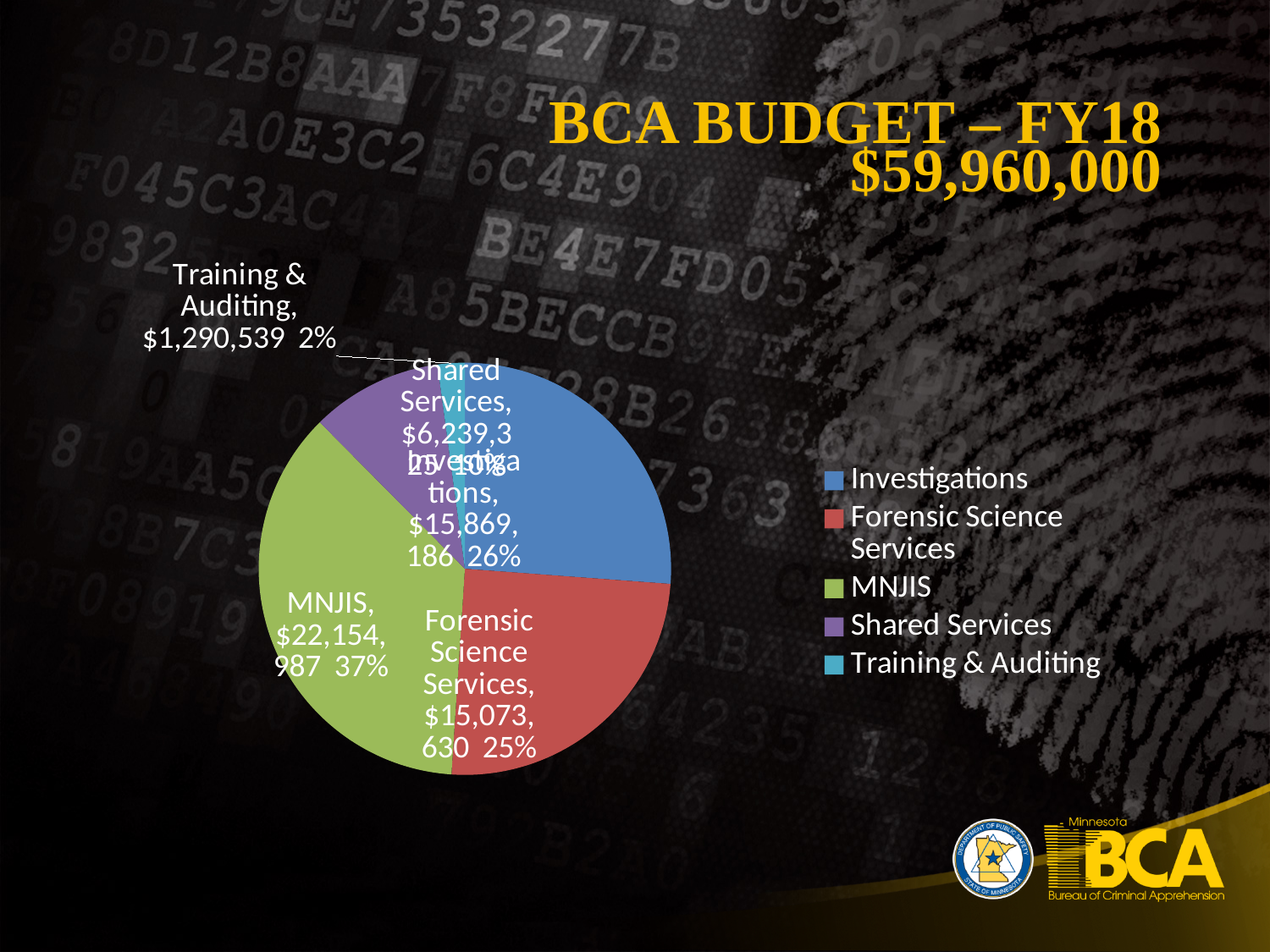
How many slices does the pie chart have? 5 Which category has the smallest share of the budget? Training & Auditing Which is larger, the budget for Investigations or for Forensic Science Services? Investigations What is the total budget shown in the slide title? $59,960,000 Which category has the largest share of the budget? MNJIS What percentage of the budget does MNJIS represent? 37% What is the budget amount for Training & Auditing? $1,290,539 What is the budget amount for MNJIS? $22,154,987 What is the budget amount for Forensic Science Services? $15,073,630 What kind of chart is shown on the slide? pie chart What is the budget amount for Investigations? $15,869,186 How many entries does the legend list? 5